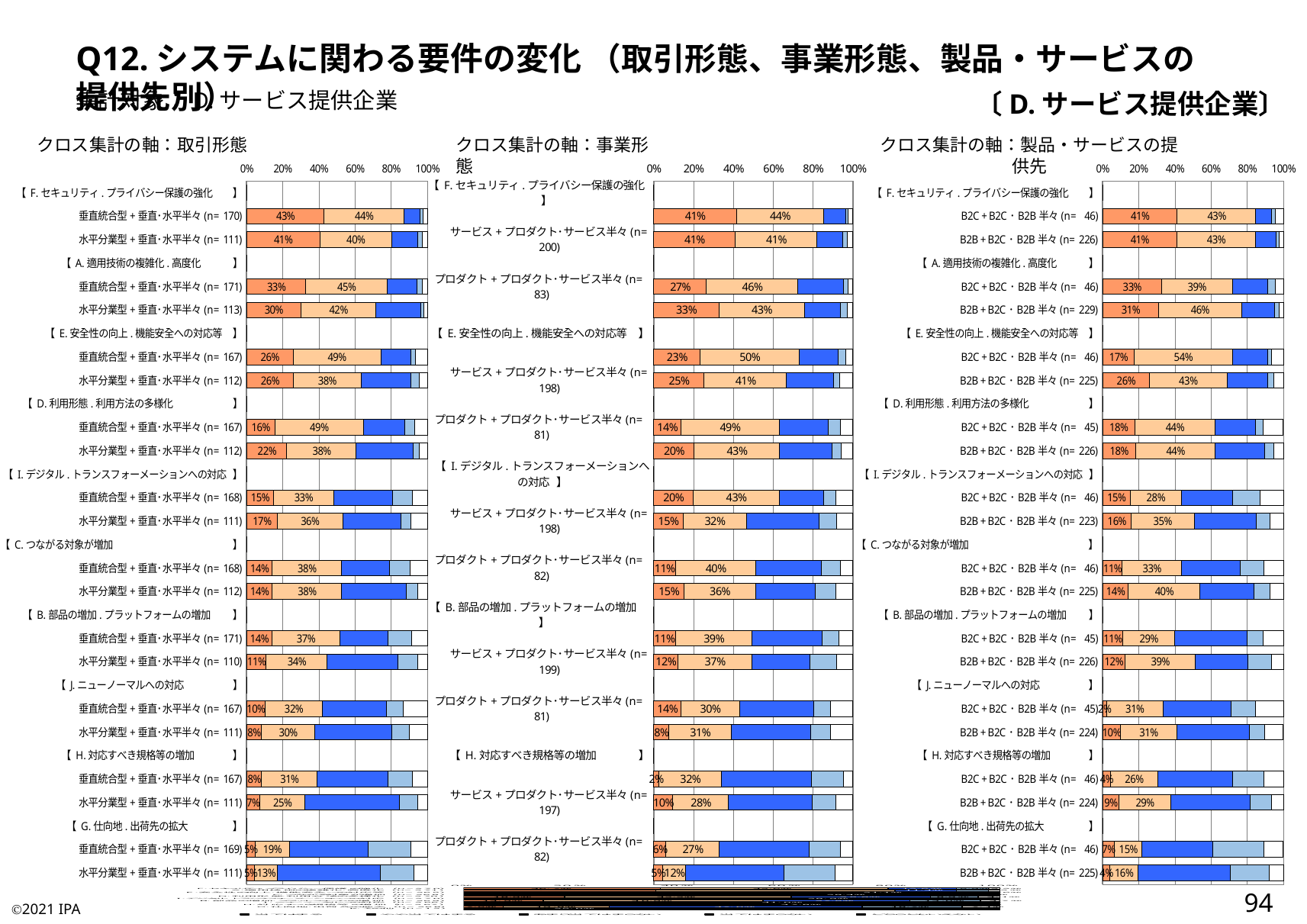
In the left chart (クロス集計の軸：取引形態), which has the larger second segment under G. 仕向地.出荷先の拡大: 垂直統合型 (n=169) or 水平分業型 (n=111)? 垂直統合型＋垂直･水平半々 (n=169) In the right chart (クロス集計の軸：製品・サービスの提供先), which has the larger first segment under H. 対応すべき規格等の増加: B2C (n=46) or B2B (n=224)? B2B＋B2C・B2B半々 (n=224) In the right chart (クロス集計の軸：製品・サービスの提供先), what is the first segment value for B2B＋B2C・B2B半々 (n=225) under C. つながる対象が増加? 14% How many charts are shown on the slide? 3 In the right chart (クロス集計の軸：製品・サービスの提供先), what is the difference between the second segment values of B2B (n=229) and B2C (n=46) under A. 適用技術の複雑化.高度化? 7% What is the maximum value shown on the x axis of the right chart? 100% What kind of chart is the left chart titled クロス集計の軸：取引形態? Stacked bar chart In the left chart (クロス集計の軸：取引形態), what is the first (leftmost) segment value for 垂直統合型＋垂直･水平半々 (n=170) under F. セキュリティ.プライバシー保護の強化? 43% In the left chart (クロス集計の軸：取引形態), what is the second segment value for 水平分業型＋垂直･水平半々 (n=112) under E. 安全性の向上.機能安全への対応等? 38% In the left chart (クロス集計の軸：取引形態), what is the difference between the first segment values of 垂直統合型 (n=167) and 水平分業型 (n=112) under D. 利用形態.利用方法の多様化? 6% What is the title of the middle chart? クロス集計の軸：事業形態 In the right chart (クロス集計の軸：製品・サービスの提供先), what is the second segment value for B2C＋B2C・B2B半々 (n=46) under E. 安全性の向上.機能安全への対応等? 54%